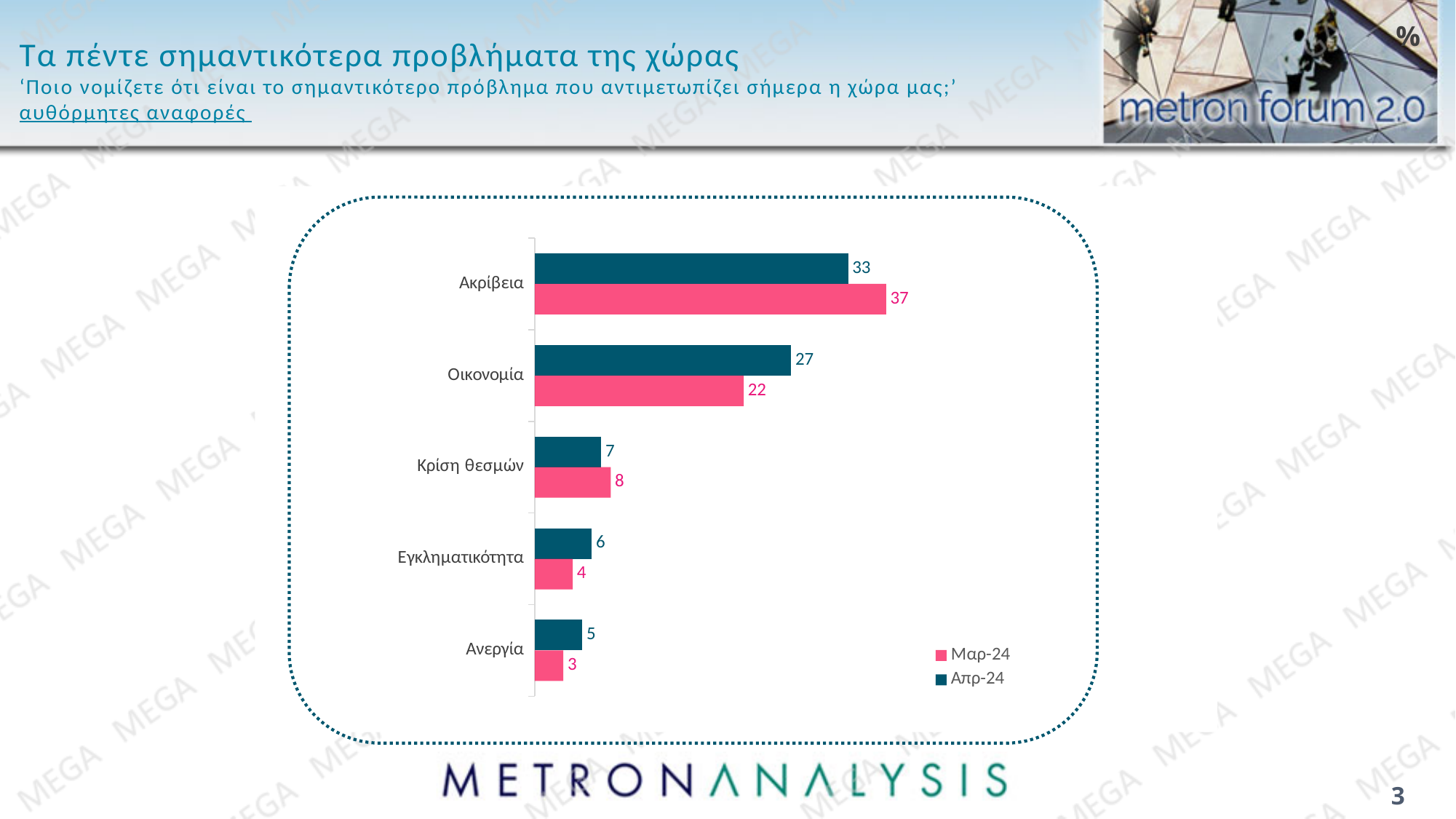
Which category has the highest value in the Απρ-24 series? Ακρίβεια How many categories are shown in the chart? 5 Which category has the lowest value in the Μαρ-24 series? Ανεργία What is the value for Ανεργία in the Απρ-24 series? 5 What kind of chart is shown on the slide? Bar chart What is the difference between the Απρ-24 and Μαρ-24 values for Οικονομία? 5 How many series does the legend list? 2 What is the value for Ακρίβεια in the Απρ-24 series? 33 What is the value for Ακρίβεια in the Μαρ-24 series? 37 Which colour represents the Μαρ-24 series in the chart? Pink What is the value for Οικονομία in the Μαρ-24 series? 22 For Εγκληματικότητα, which series has the larger value, Μαρ-24 or Απρ-24? Απρ-24